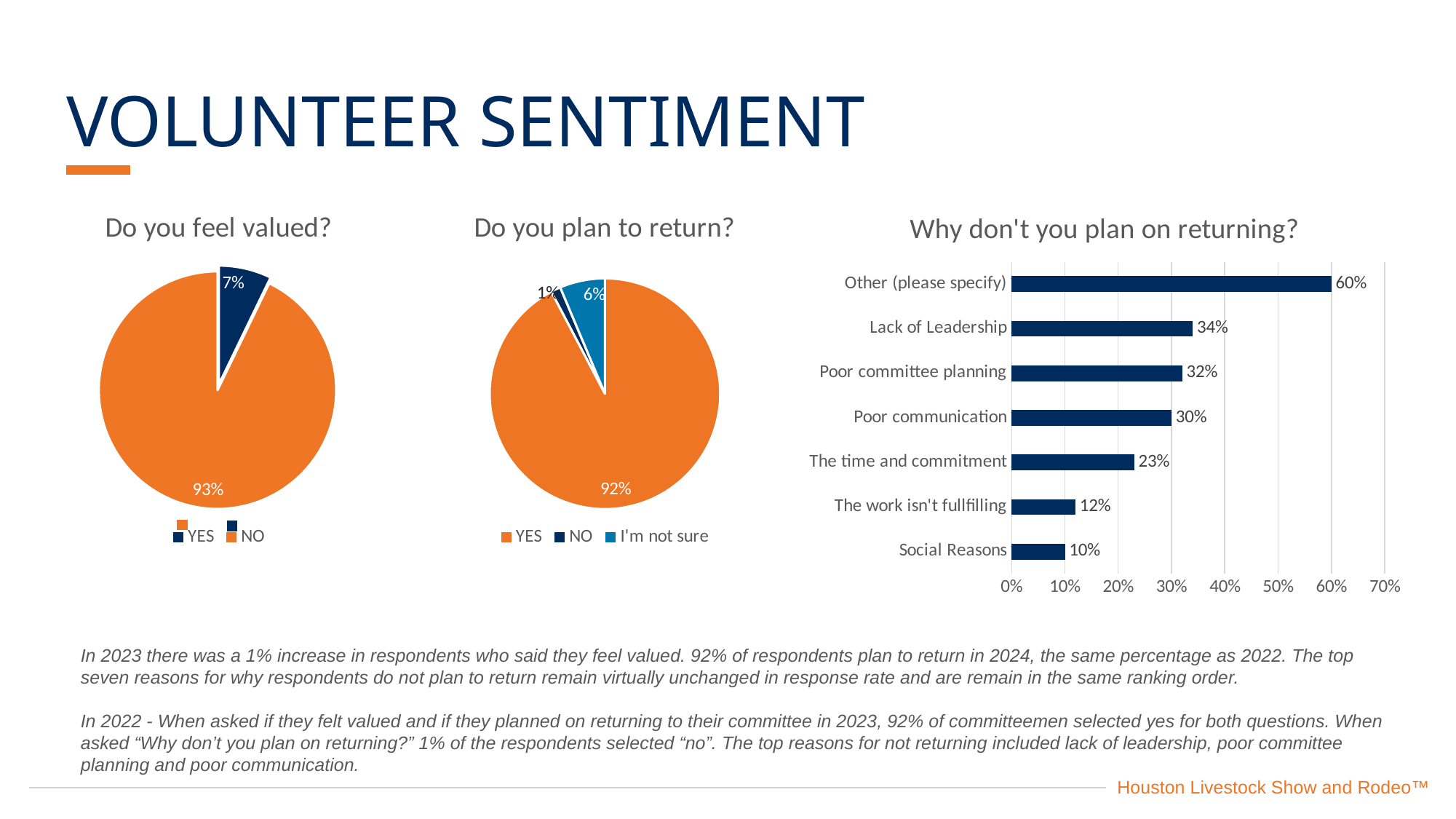
In the 'Why don't you plan on returning?' chart, which reason has the lowest value? Social Reasons In the 'Do you plan to return?' chart, what percentage answered 'I'm not sure'? 6% In the 'Do you feel valued?' chart, what is the value of the largest slice? 93% In the 'Why don't you plan on returning?' chart, what is the difference between Other (please specify) and Lack of Leadership? 26% How many entries does the legend of the 'Do you plan to return?' chart list? 3 In the 'Why don't you plan on returning?' chart, which is larger: Poor committee planning or Poor communication? Poor committee planning In the 'Why don't you plan on returning?' chart, which reason has the highest value? Other (please specify) How many reasons are listed in the 'Why don't you plan on returning?' chart? 7 What kind of chart is 'Do you feel valued?'? Pie chart What kind of chart is 'Why don't you plan on returning?'? Bar chart In the 'Do you plan to return?' chart, what percentage answered YES? 92% In the 'Why don't you plan on returning?' chart, what is the value for Lack of Leadership? 34%